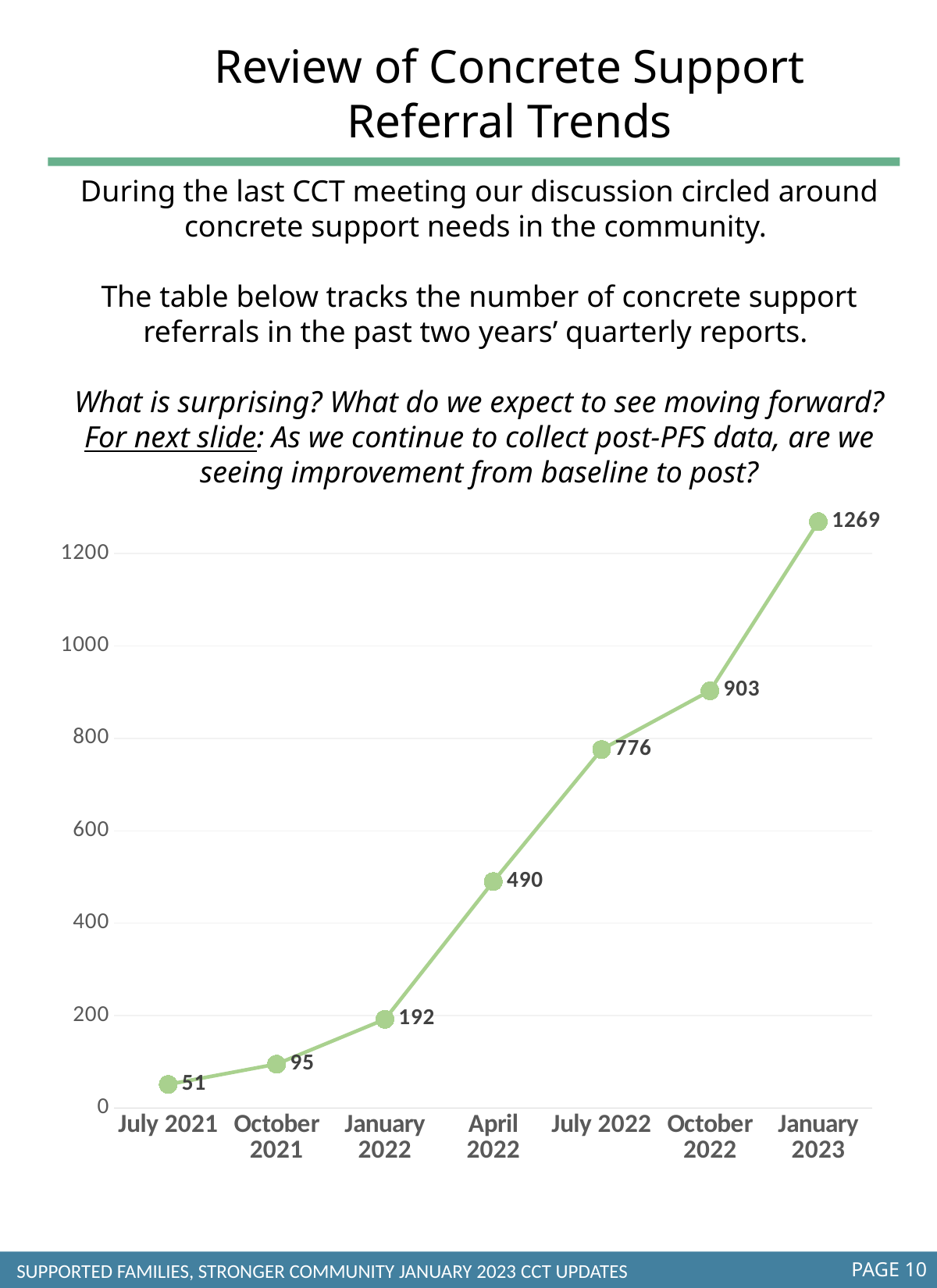
What is the number of concrete support referrals for April 2022? 490 What is the number of concrete support referrals for October 2022? 903 Which quarter has the highest number of concrete support referrals? January 2023 Which has more referrals, January 2022 or October 2021? January 2022 How many quarterly data points are plotted on the chart? 7 What is the difference in referrals between July 2022 and April 2022? 286 Is the value for July 2022 greater or less than 800? less What is the number of concrete support referrals for July 2021? 51 Which quarter has the lowest number of concrete support referrals? July 2021 Do the referral numbers rise or fall from July 2021 to January 2023? rise What is the difference in referrals between January 2023 and October 2022? 366 What kind of chart is shown on the slide? line chart